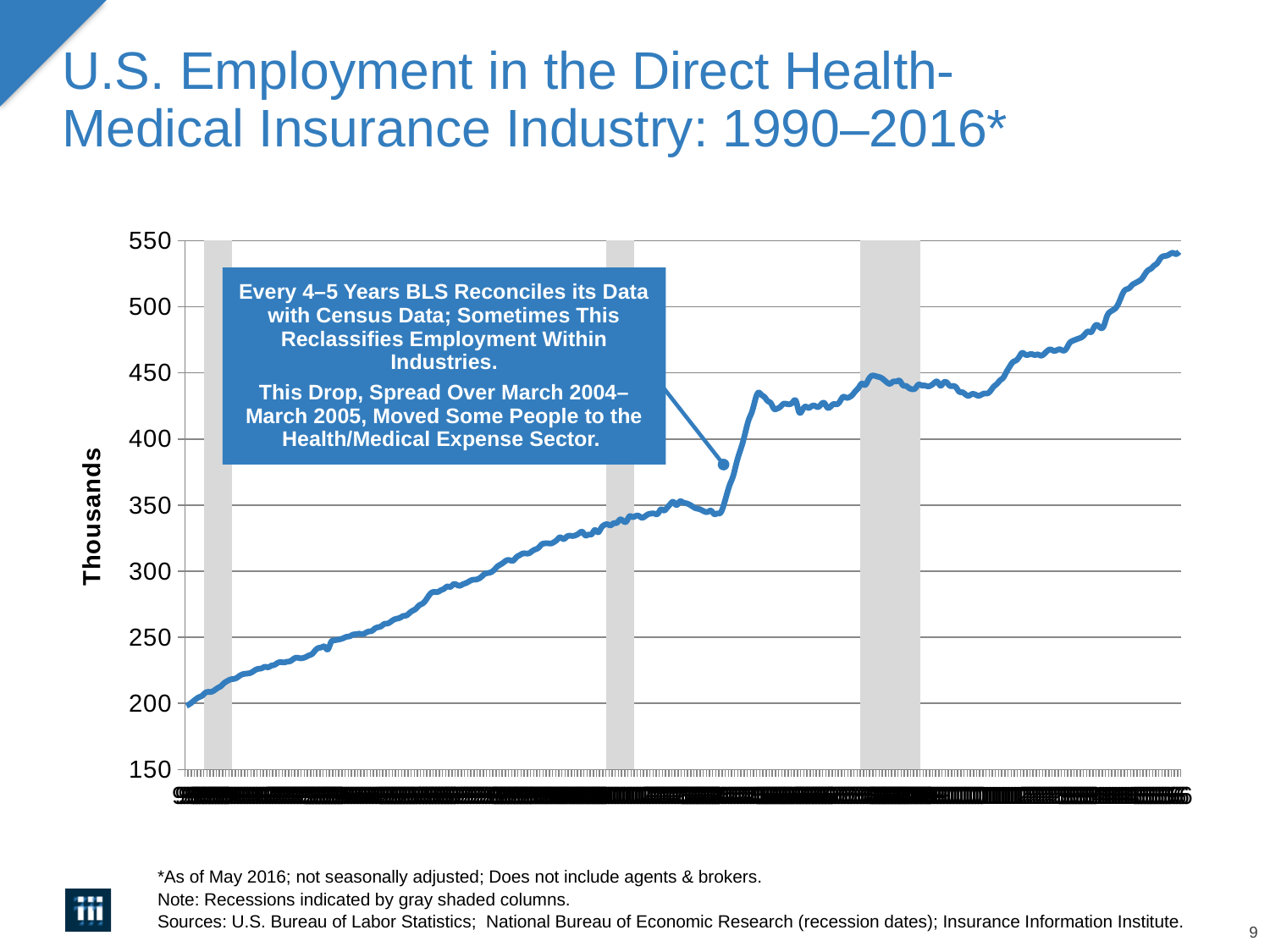
Is the employment value at the end of the series (2016) greater or less than 500? greater Is the employment value at the low point of the drop spread over March 2004–March 2005 greater or less than 400? less Is the employment value just before the March 2004–March 2005 drop greater or less than 400? less What is the highest value shown on the vertical axis of the chart? 550 Is the employment value at the end of the series (2016) greater or less than the value at the start of the series (1990)? greater What kind of chart is shown on the slide? line chart Overall, does employment rise or fall from the start of the series in 1990 to the end in 2016? rise What is the label on the vertical axis of the chart? Thousands What is the title of the chart? U.S. Employment in the Direct Health-Medical Insurance Industry: 1990–2016*